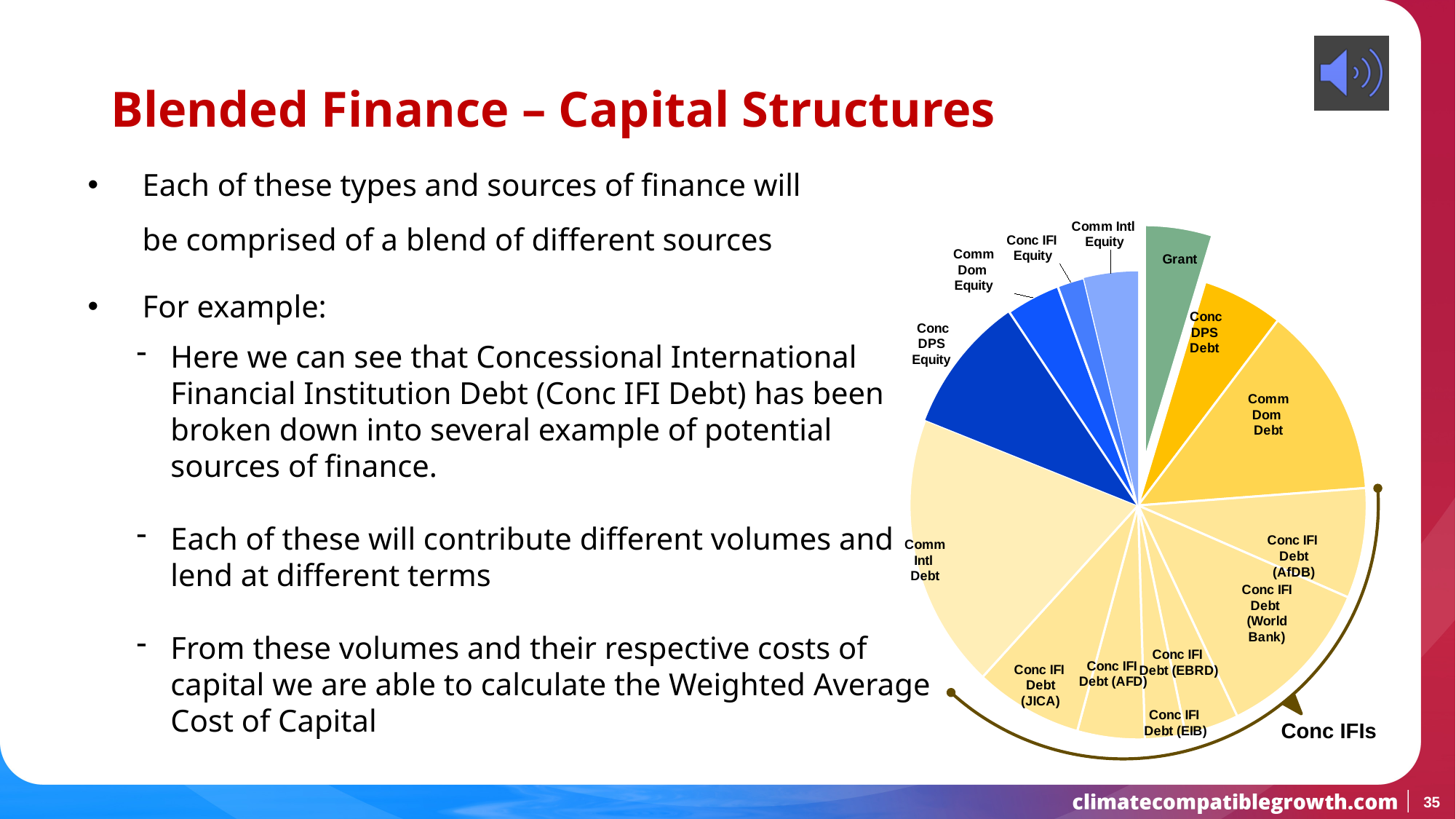
What label is shown on the bracket grouping the Conc IFI Debt slices? Conc IFIs Which is larger in the pie chart, Conc IFI Debt (AfDB) or Conc IFI Debt (EIB)? Conc IFI Debt (AfDB) How many slices does the pie chart have? 14 Which slice of the pie chart is pulled out (exploded) from the rest? Grant What kind of chart is shown on the slide? pie chart Which is larger in the pie chart, Conc DPS Equity or Grant? Conc DPS Equity Which is larger in the pie chart, Comm Intl Debt or Comm Dom Debt? Comm Intl Debt How many slices in the pie chart are labelled as Conc IFI Debt sources? 6 Which slice of the pie chart is the largest? Comm Intl Debt